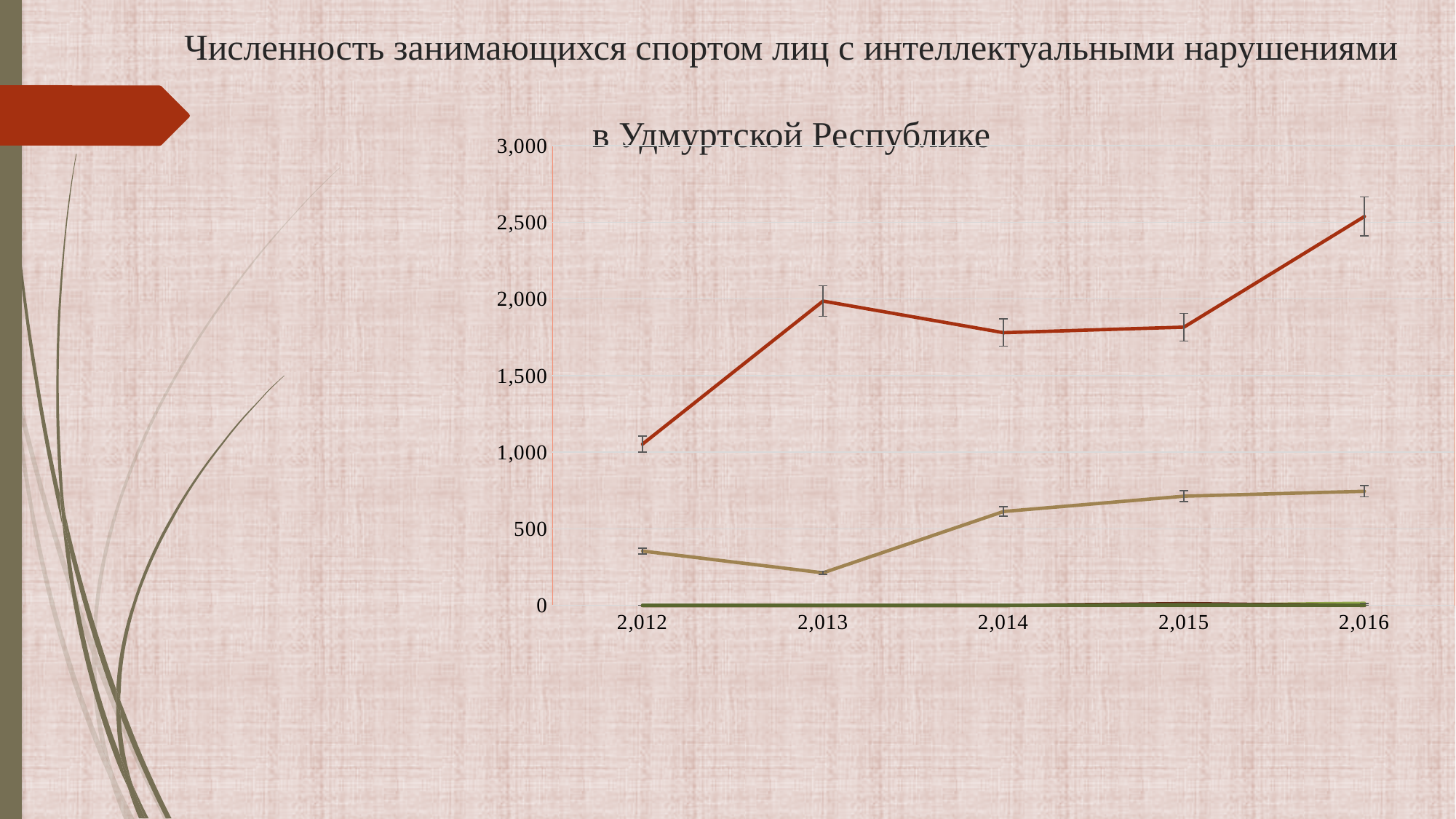
Is the value of the red line in 2,012 greater or less than 1,500? less Is the value of the tan (light brown) line in 2,016 greater or less than 500? greater In which year does the red line reach its highest value? 2,016 In which year does the tan (light brown) line have its lowest value? 2,013 Does the tan (light brown) line rise or fall between 2,013 and 2,016? rise How many years are shown on the x axis of the chart? 5 In which year does the red line have its lowest value? 2,012 Is the value of the red line in 2,016 greater or less than 2,000? greater What kind of chart is shown on the slide? line chart For the red line, which year has the larger value: 2,013 or 2,014? 2,013